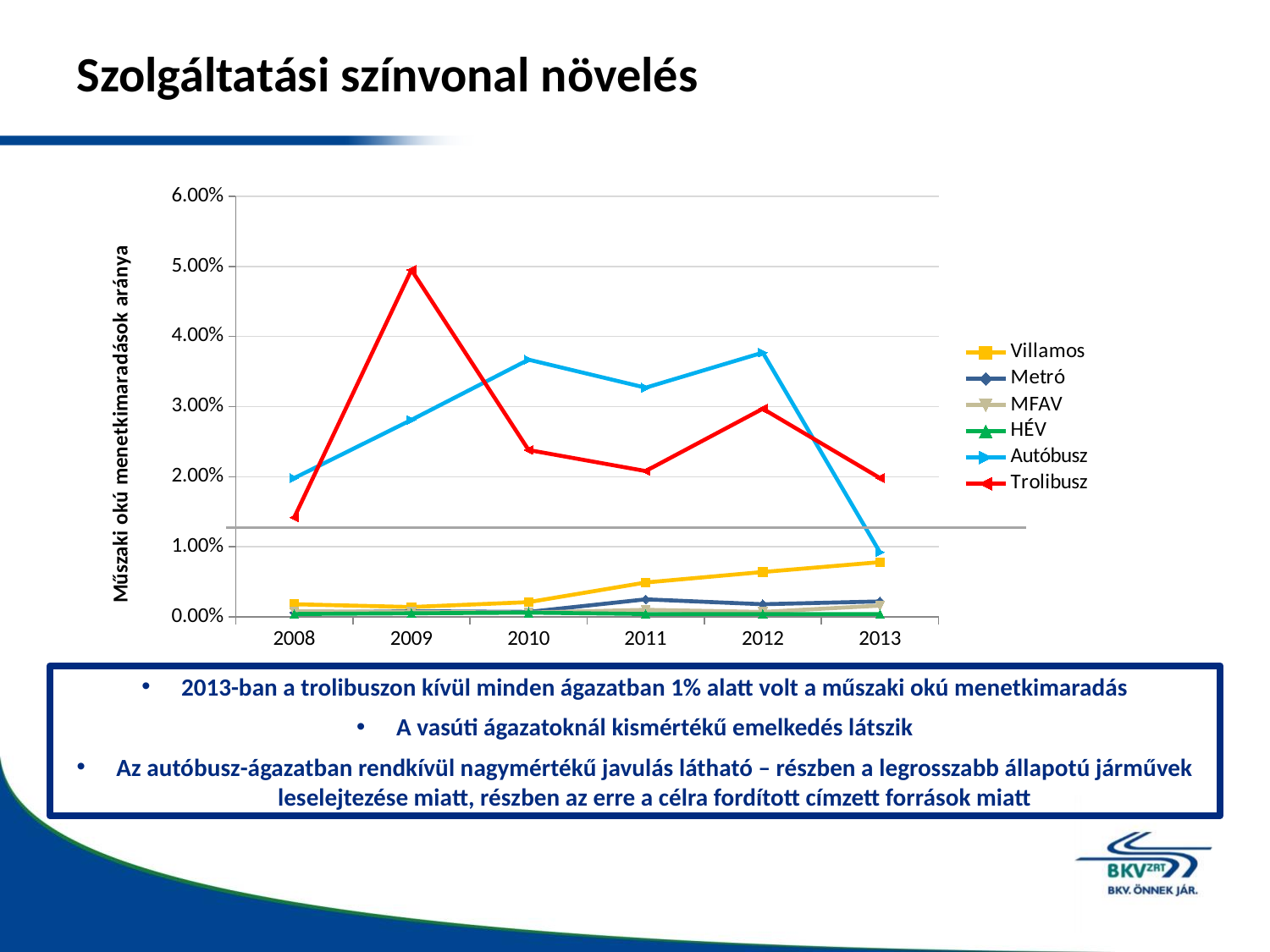
Which series has the highest value in 2009? Trolibusz In 2010, which is larger: Autóbusz or Trolibusz? Autóbusz How many years are shown on the x axis? 6 In 2013, which is larger: Trolibusz or Autóbusz? Trolibusz What is the label of the y axis? Műszaki okú menetkimaradások aránya Is the value for Autóbusz in 2013 greater or less than 2.00%? less Does the Villamos line rise or fall from 2010 to 2013? rise Is the value for Trolibusz in 2009 greater or less than 4.00%? greater Which series has the highest value in 2012? Autóbusz Is the value for Autóbusz in 2012 greater or less than 3.00%? greater What kind of chart is shown on the slide? line chart How many series does the legend list? 6